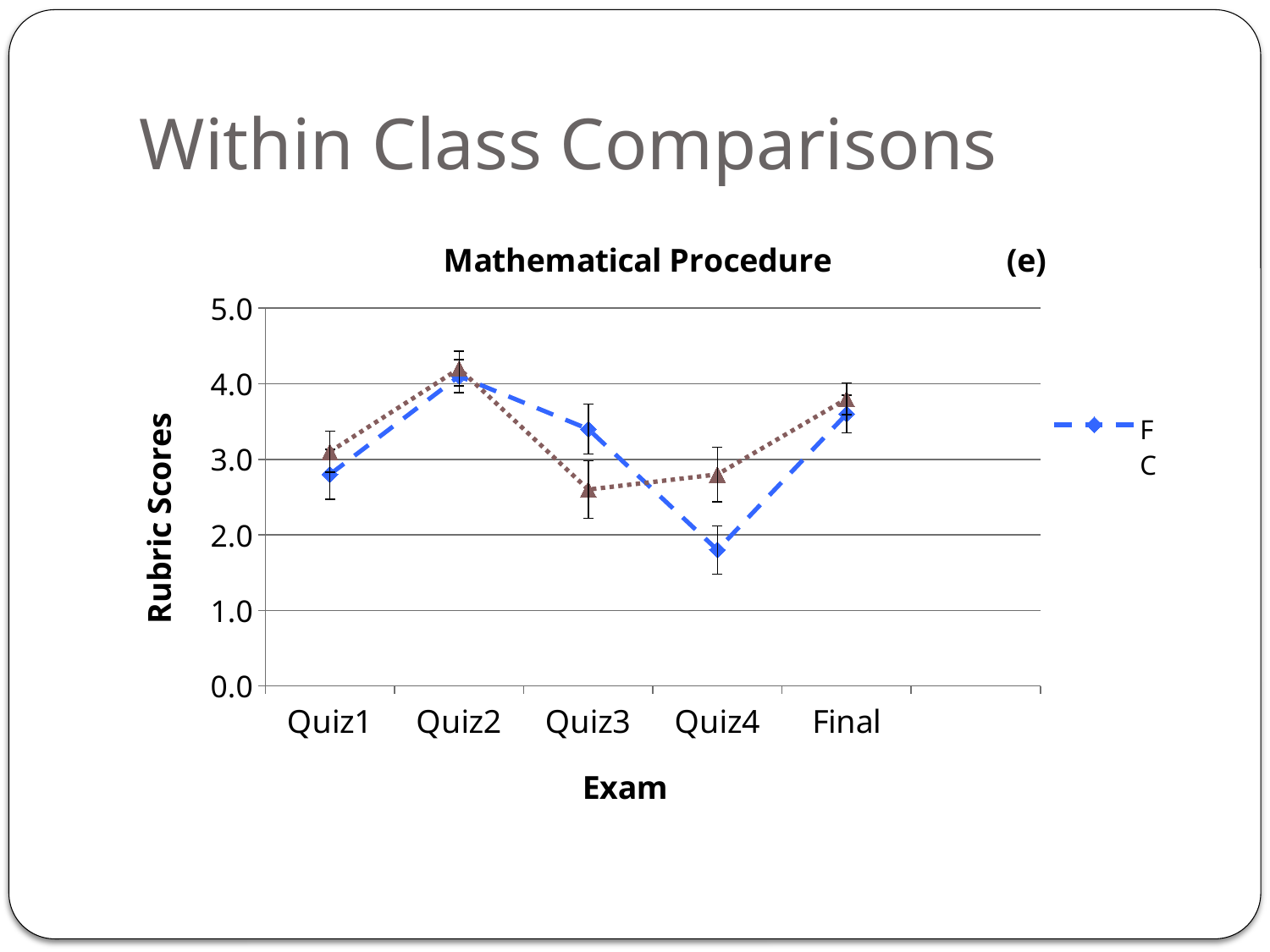
Is the value for series C at Quiz3 greater or less than 3.0? less At Quiz4, which series has the higher rubric score, F or C? C Is the value for series C at Final greater or less than 3.0? greater What is the title of the y axis? Rubric Scores For which exam does series C reach its highest rubric score? Quiz2 How many series does the legend list? 2 Is the value for series F at Quiz3 greater or less than 3.0? greater How many exams are plotted along the x axis? 5 For which exam does series F reach its highest rubric score? Quiz2 What kind of chart is shown on the slide? line chart For which exam does series F have its lowest rubric score? Quiz4